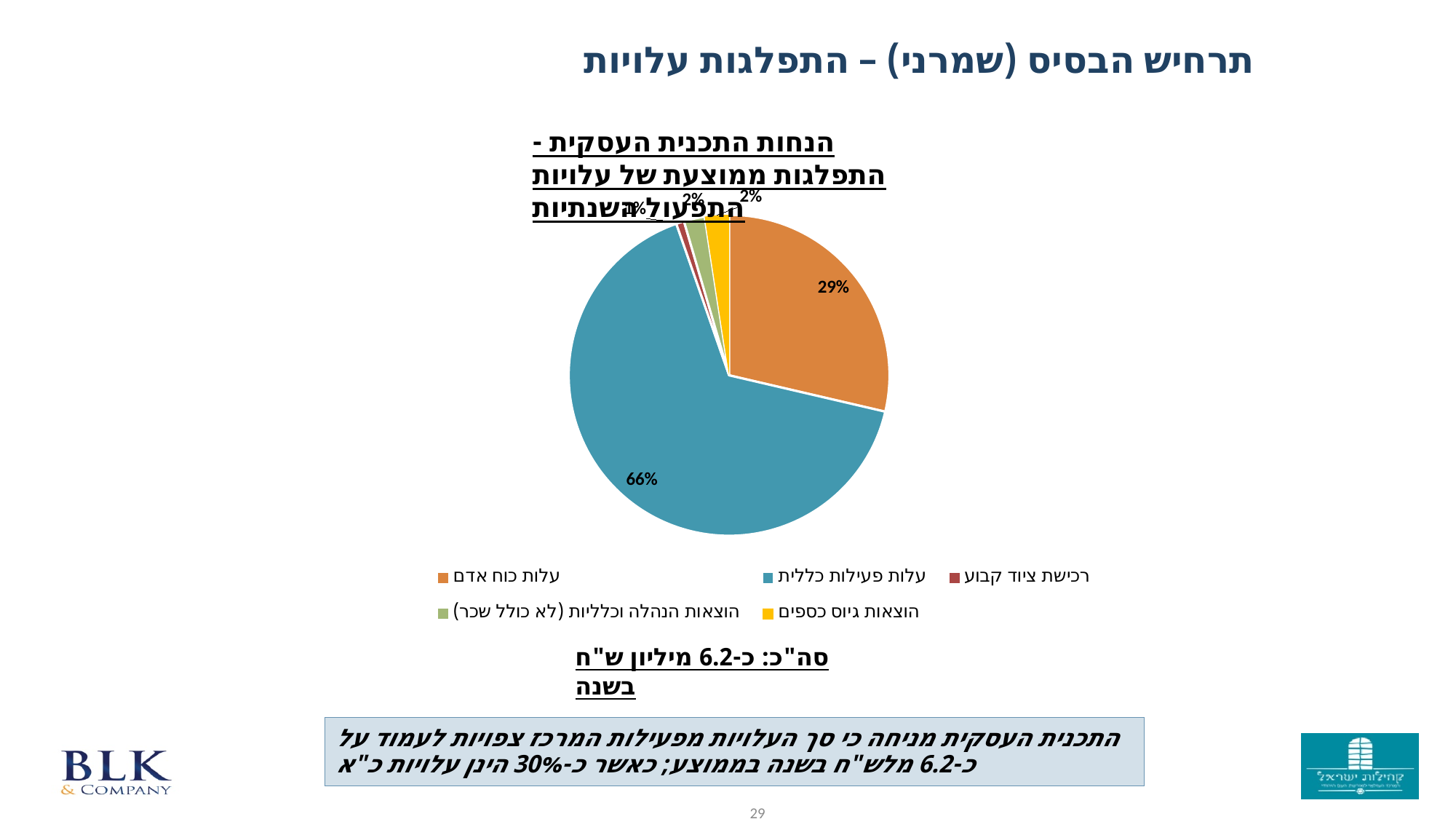
What share of the pie does עלות פעילות כללית represent? 66% What share of the pie does הוצאות הנהלה וכלליות (לא כולל שכר) represent? 2% Which category has the smallest slice of the pie? רכישת ציוד קבוע What colour is the slice for עלות פעילות כללית? Blue What total annual cost is stated below the pie chart? כ-6.2 מיליון ש"ח בשנה What share of the pie does הוצאות גיוס כספים represent? 2% Which is larger: the slice for עלות כוח אדם or the slice for עלות פעילות כללית? עלות פעילות כללית By how many percentage points does עלות פעילות כללית exceed עלות כוח אדם? 37 percentage points What kind of chart is shown on the slide? Pie chart What share of the pie does עלות כוח אדם represent? 29% Which category has the largest slice of the pie? עלות פעילות כללית How many categories does the legend of the pie chart list? 5